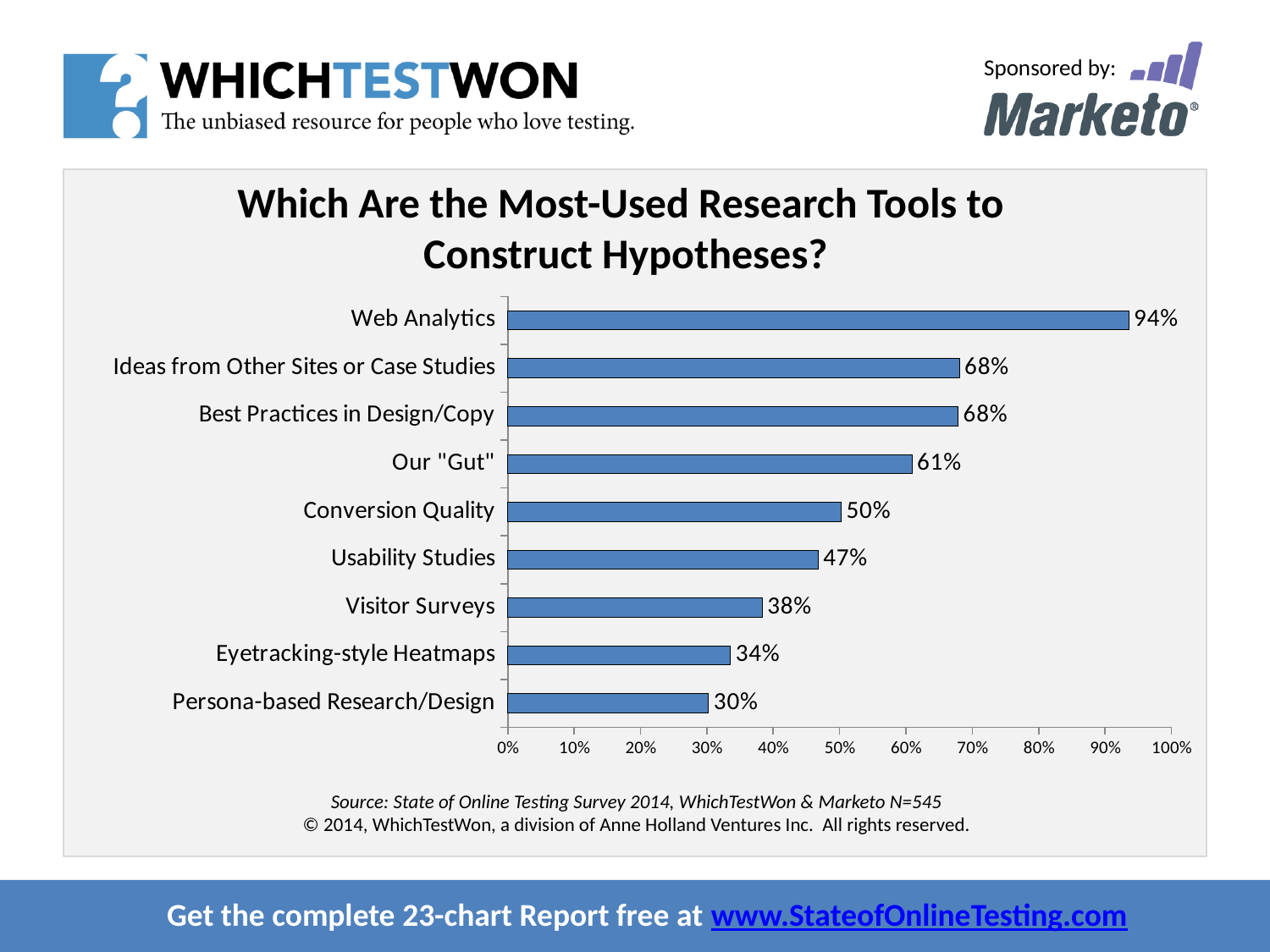
What is the difference between the values for Web Analytics and Conversion Quality? 44% Which is larger, the value for Conversion Quality or the value for Visitor Surveys? Conversion Quality What kind of chart is shown on the slide? bar chart Which research tool has the lowest value? Persona-based Research/Design Is the value for Usability Studies greater or less than 50%? less What is the difference between the values for Usability Studies and Visitor Surveys? 9% How many research tools are shown in the chart? 9 What is the value for Eyetracking-style Heatmaps? 34% What is the title of the chart? Which Are the Most-Used Research Tools to Construct Hypotheses? What is the value for Web Analytics? 94% What is the value for Our "Gut"? 61% Which research tool has the highest value? Web Analytics